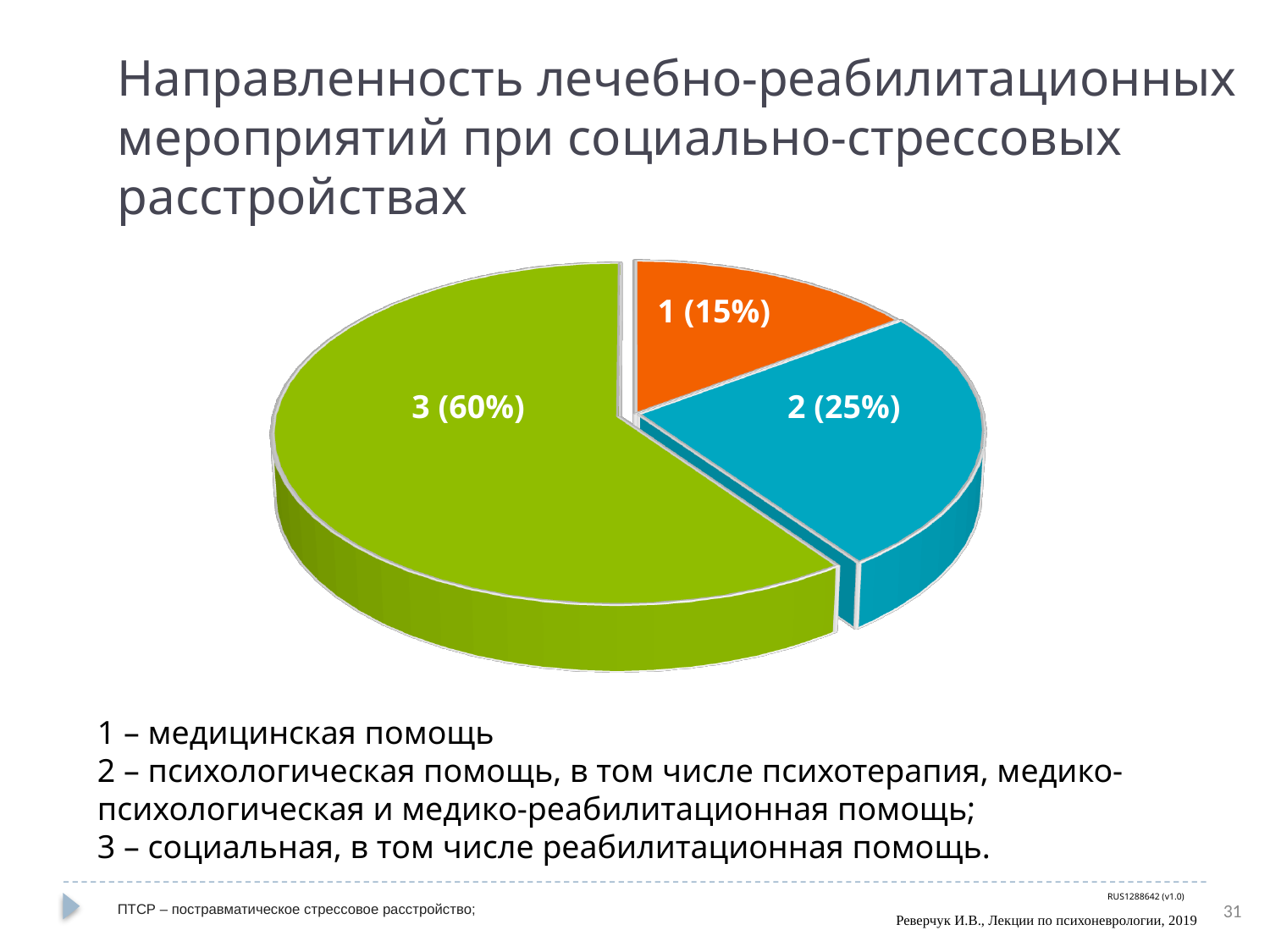
What kind of chart is shown on the slide? pie chart What share of the pie does slice 2 (психологическая помощь) have? 25% How many slices does the pie chart have? 3 What colour is the slice labelled 1 (15%)? orange What is the difference in percentage points between slice 3 and slice 2? 35% What share of the pie does slice 1 (медицинская помощь) have? 15% Which is larger, slice 1 or slice 2? slice 2 Which slice of the pie is the largest? 3 (60%) What share of the pie does slice 3 (социальная помощь) have? 60% What is the difference in percentage points between slice 2 and slice 1? 10% What colour is the slice labelled 3 (60%)? green Which slice of the pie is the smallest? 1 (15%)